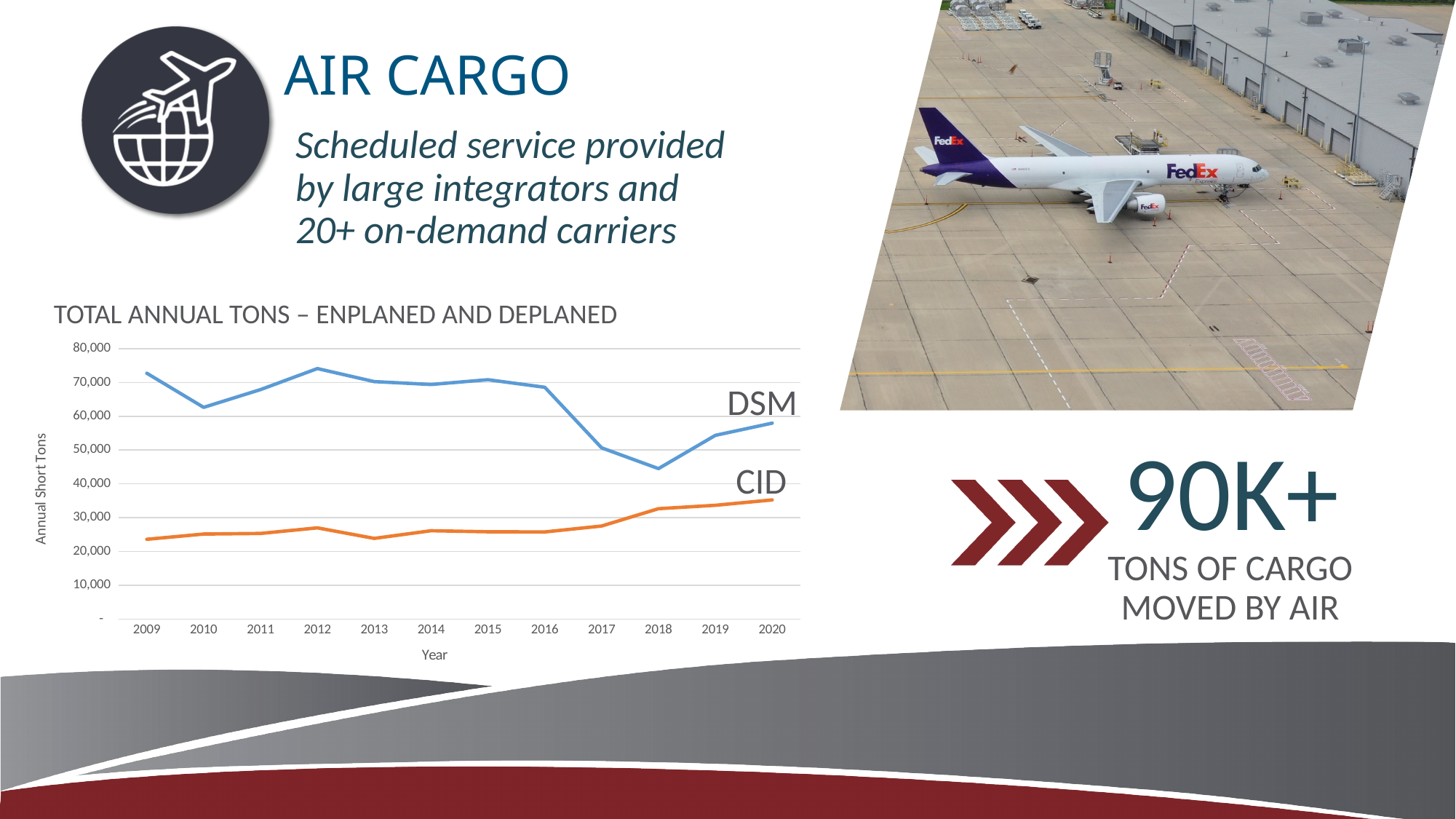
In which year is the DSM value lowest? 2018 Is the value for CID in 2013 greater or less than 30,000? less In which year is the CID value highest? 2020 Which series has the higher value in 2016, DSM or CID? DSM What is the label on the vertical axis of the chart? Annual Short Tons Is the value for DSM in 2018 greater or less than 50,000? less Is the value for CID in 2020 greater or less than 30,000? greater How many years are shown on the x axis of the chart? 12 What is the title of the chart? TOTAL ANNUAL TONS – ENPLANED AND DEPLANED How many series are plotted in the chart? 2 What kind of chart is shown under the title "TOTAL ANNUAL TONS – ENPLANED AND DEPLANED"? Line chart